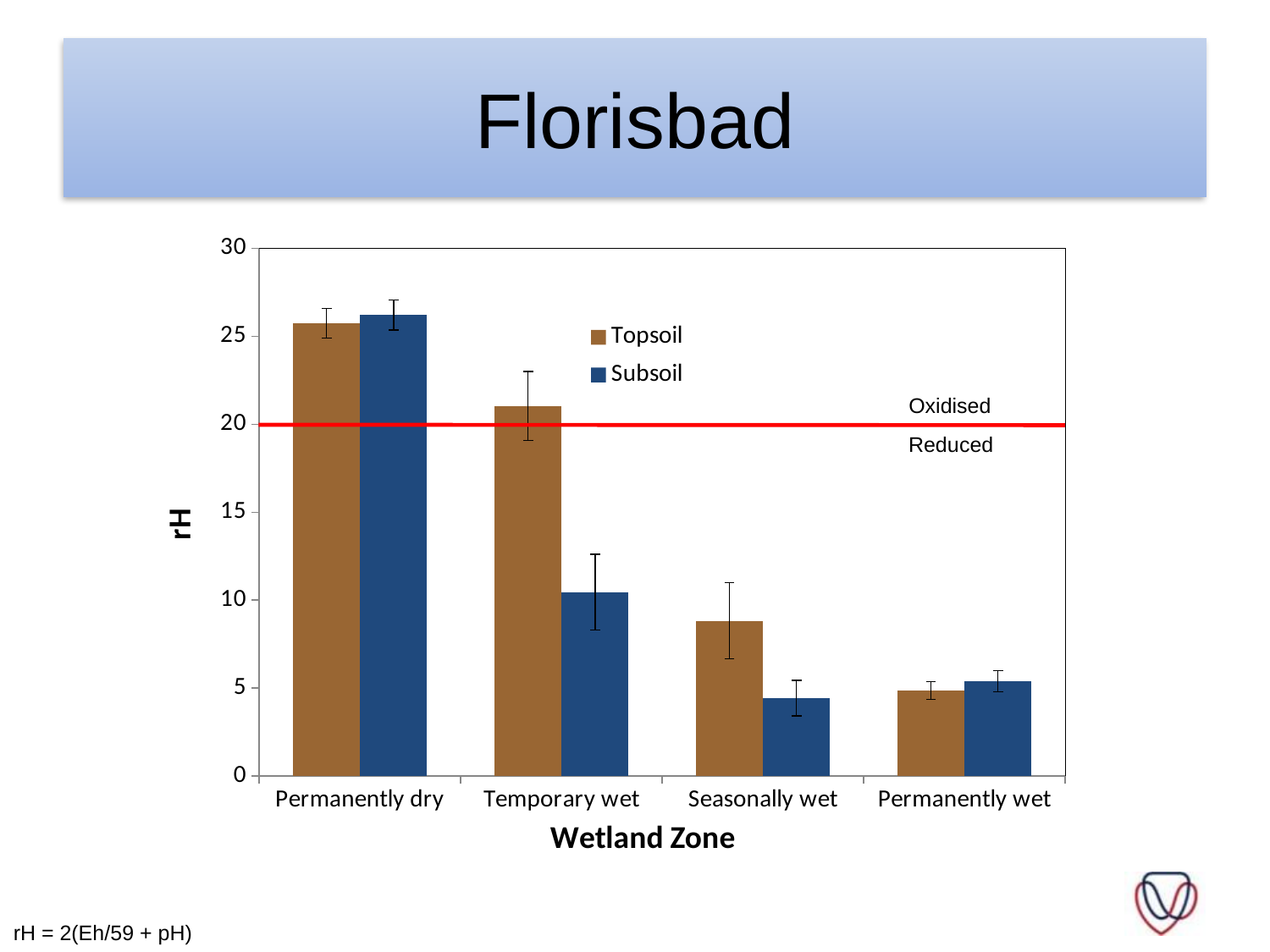
What does the red horizontal line at rH 20 separate, according to the labels on the chart? Oxidised and Reduced Do the Topsoil rH values rise or fall moving from Permanently dry to Permanently wet along the x axis? fall How many series does the legend list? 2 Which wetland zone has the lowest Topsoil rH value? Permanently wet For Temporary wet, which is larger, the Topsoil or the Subsoil rH value? Topsoil Is the Topsoil rH value for Temporary wet greater or less than 20? greater Which wetland zone has the highest Subsoil rH value? Permanently dry What kind of chart is shown on the slide? bar chart Is the Subsoil rH value for Temporary wet greater or less than 15? less How many wetland zones are shown on the x axis? 4 Which wetland zone has the highest Topsoil rH value? Permanently dry Is the Topsoil rH value for Seasonally wet greater or less than 10? less